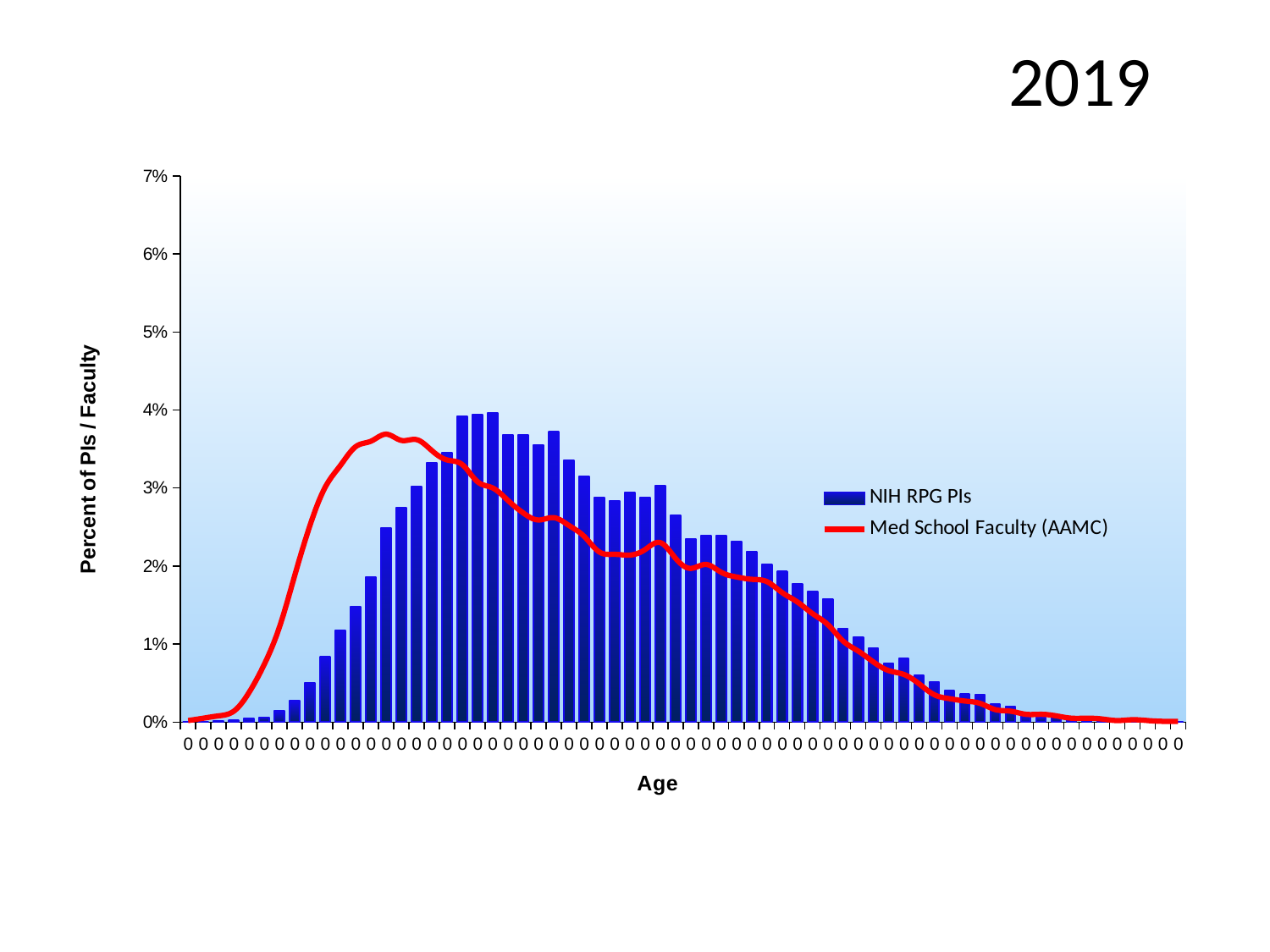
Does the Med School Faculty (AAMC) line reach its peak before or after the NIH RPG PIs bars reach their peak along the Age axis? before Is the peak of the Med School Faculty (AAMC) line greater or less than 4%? less What kind of chart is shown on the slide? A bar chart with a line overlay How many series does the legend list? 2 Which series is drawn as blue bars? NIH RPG PIs Toward the right end of the Age axis, do the NIH RPG PIs values rise or fall? fall What is the label on the horizontal axis? Age What is the highest value shown on the vertical axis? 7% Is the tallest NIH RPG PIs bar greater or less than 5%? less Which series is drawn as a red line? Med School Faculty (AAMC) Is the tallest NIH RPG PIs bar greater or less than 3%? greater What is the label on the vertical axis? Percent of PIs / Faculty